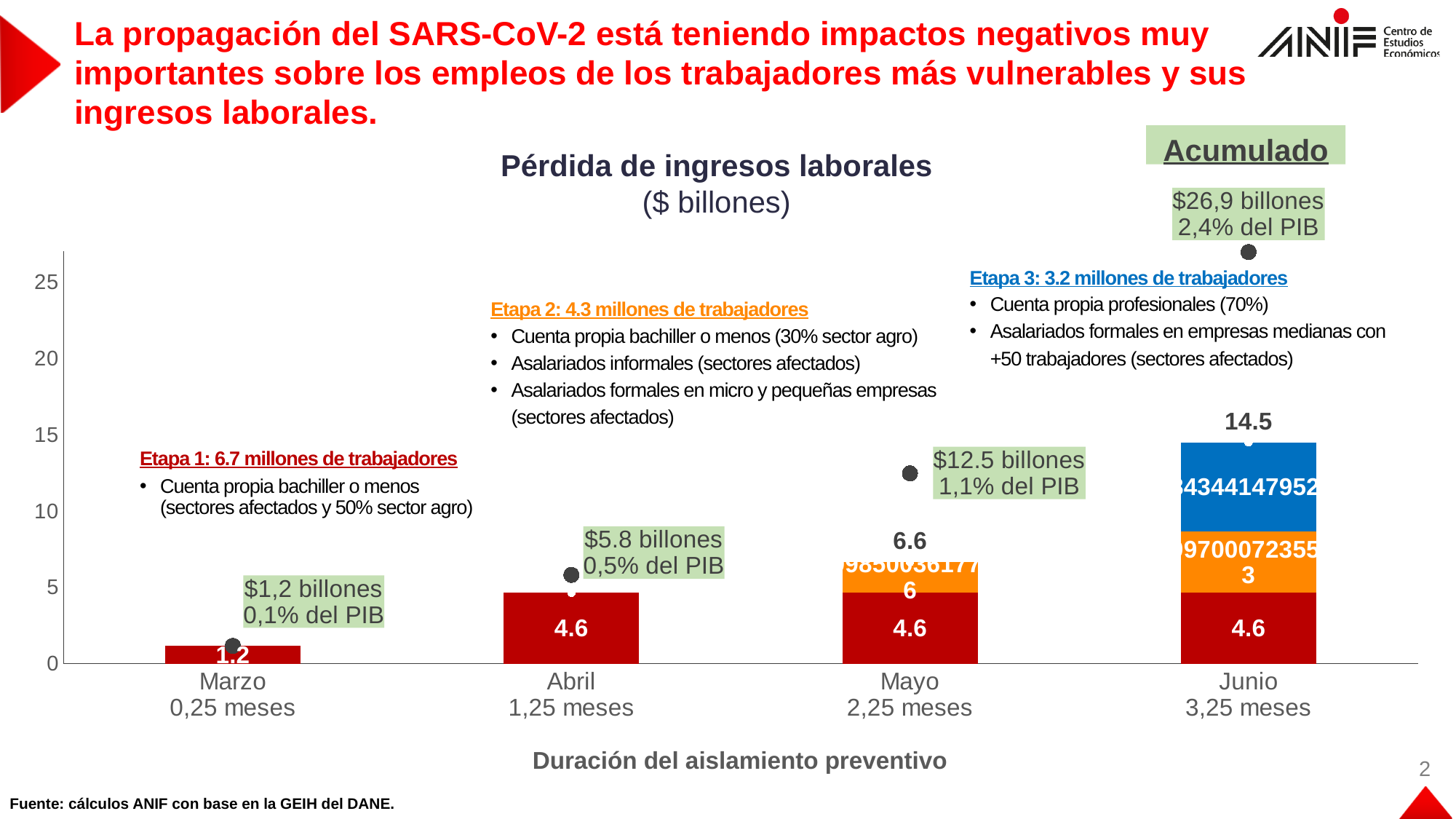
What kind of chart is shown on the slide? bar chart Do the bar totals rise or fall from Marzo to Junio? rise Which month has the lowest total bar? Marzo What is the difference between the total for Junio (14.5) and the total for Mayo (6.6)? 7.9 What is the total value labelled above the Junio bar? 14.5 What is the value of the red segment for Marzo? 1.2 How many months (categories) are shown on the x axis of the chart? 4 What is the value of the red segment for Abril? 4.6 Which month has the highest total bar? Junio What is the title of the chart? Pérdida de ingresos laborales ($ billones) What is the total value labelled above the Mayo bar? 6.6 Is the bar for Abril greater or less than 5? less